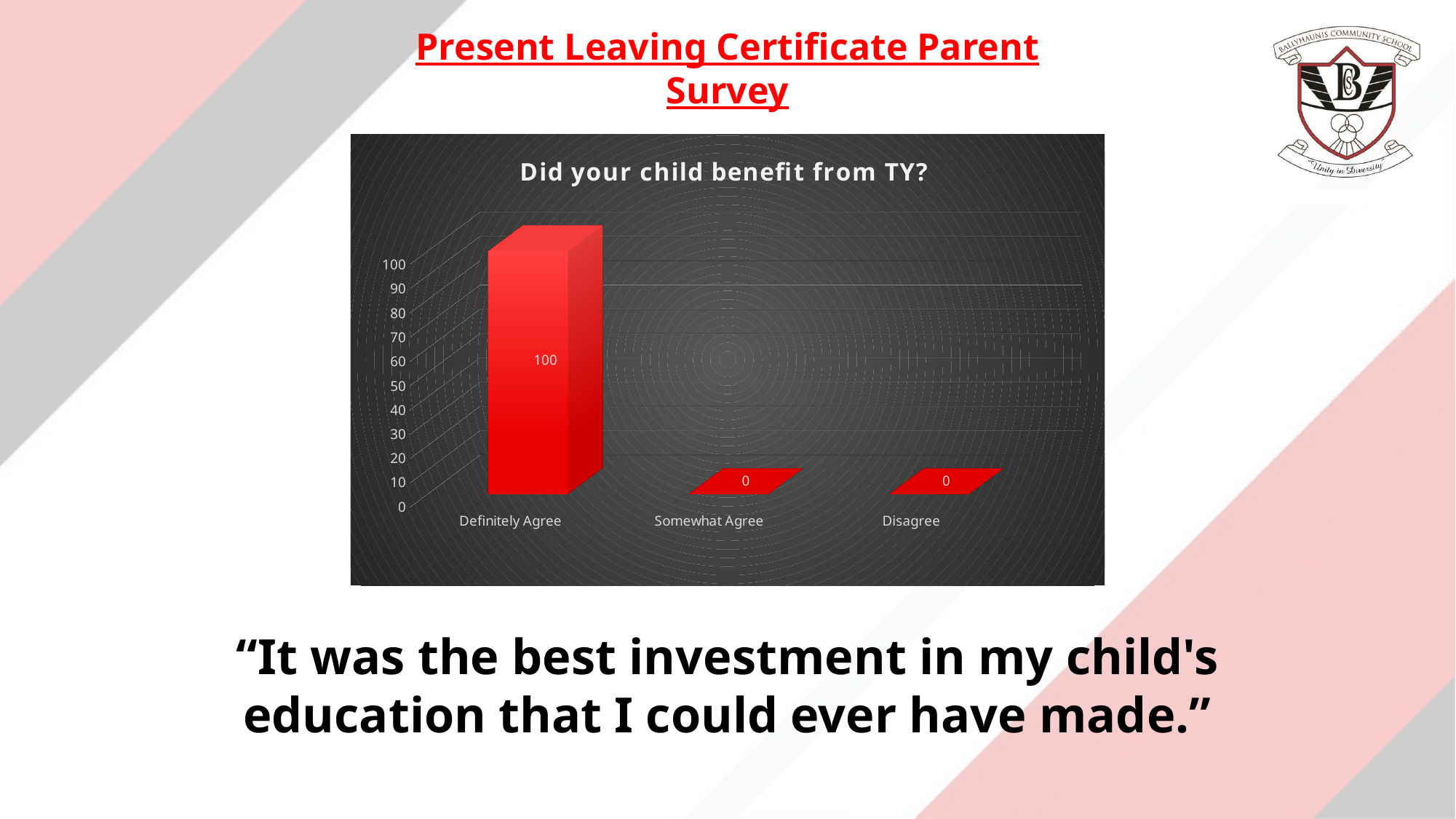
What is the difference between the values for Definitely Agree and Disagree? 100 Is the value for Definitely Agree greater or less than 50? greater What is the value for Somewhat Agree? 0 What is the highest value shown on the vertical axis? 100 What is the title of the chart? Did your child benefit from TY? What is the value for Definitely Agree? 100 What kind of chart is shown on the slide? bar chart Which is larger, the value for Definitely Agree or the value for Somewhat Agree? Definitely Agree What is the value for Disagree? 0 What is the total of the values for all three categories? 100 How many categories are shown on the x axis? 3 Which category has the highest value? Definitely Agree